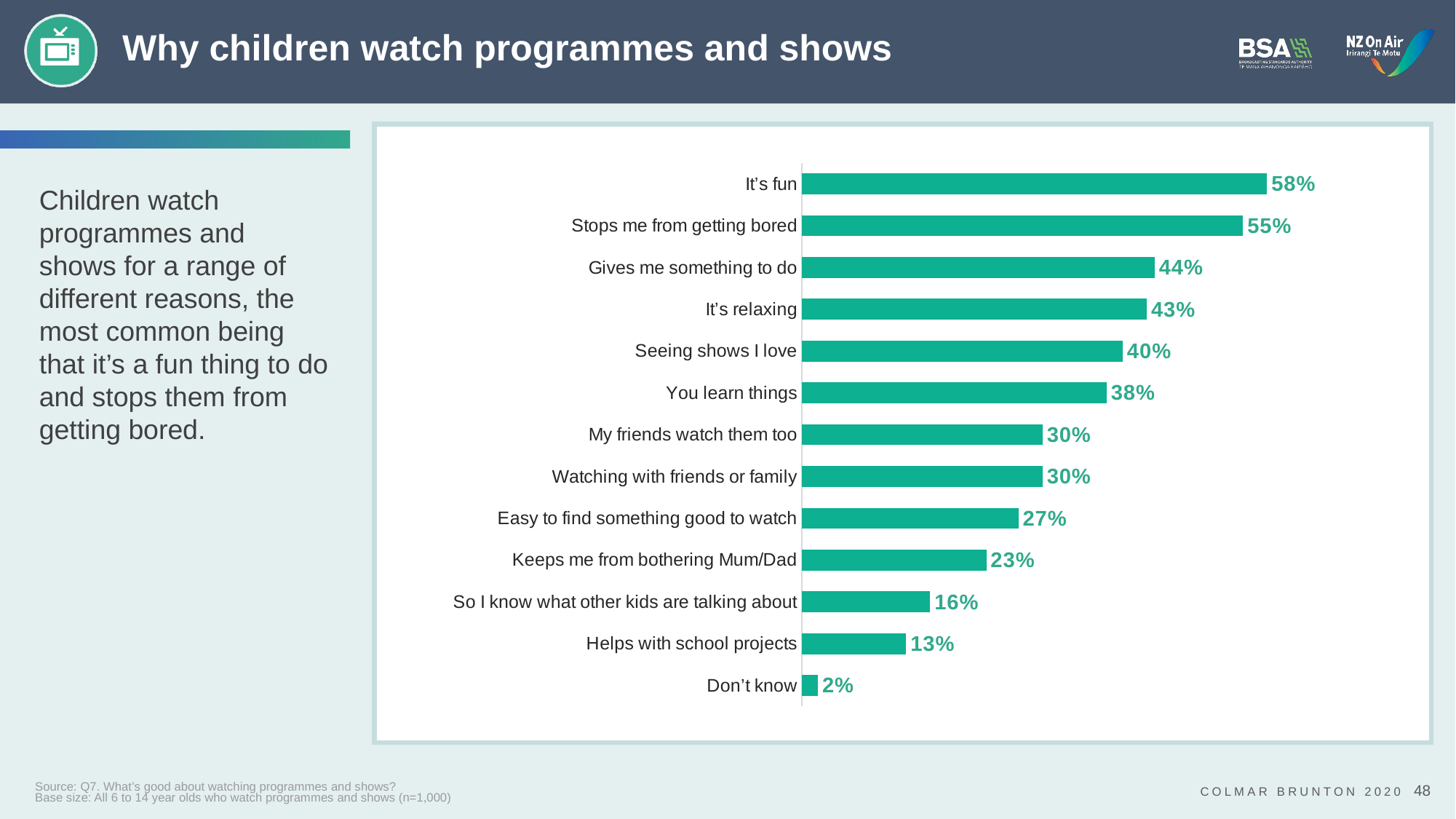
Which reason has the highest percentage? It's fun What is the value for 'Helps with school projects'? 13% Which is larger: 'Seeing shows I love' or 'Easy to find something good to watch'? Seeing shows I love What is the difference between 'It's fun' and 'Stops me from getting bored'? 3% What percentage of children say they watch programmes and shows because it's fun? 58% What is the difference between 'You learn things' and 'Helps with school projects'? 25% Which reason has the lowest percentage? Don't know What kind of chart is shown on the slide? Bar chart Which two reasons both have a value of 30%? My friends watch them too; Watching with friends or family How many reasons (categories) are shown in the chart? 13 What is the value for 'Keeps me from bothering Mum/Dad'? 23% What colour are the bars in the chart? Green